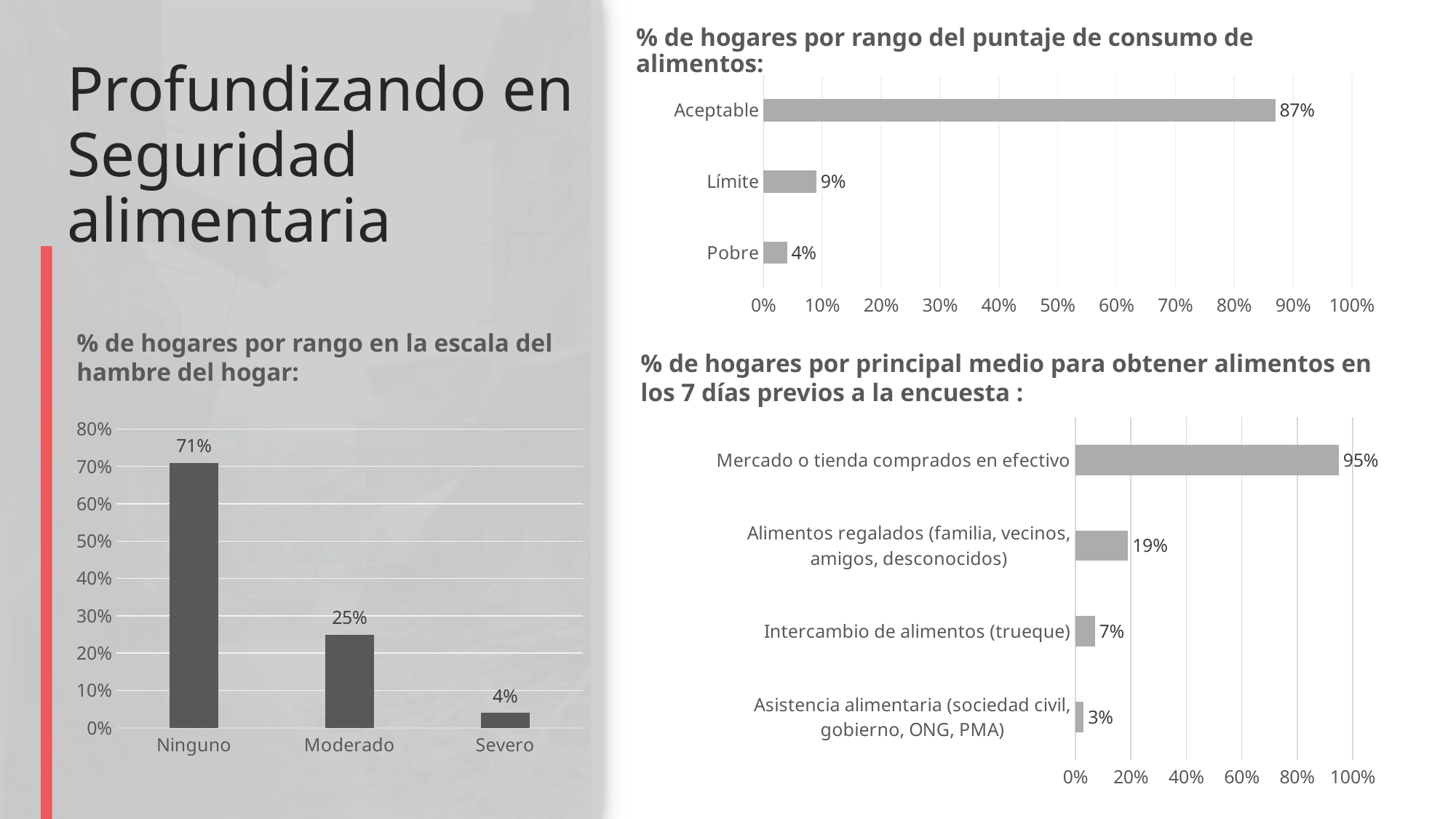
In the chart '% de hogares por rango del puntaje de consumo de alimentos', what kind of chart is it? Bar chart In the chart '% de hogares por rango en la escala del hambre del hogar', what is the value for Ninguno? 71% In the chart '% de hogares por rango en la escala del hambre del hogar', which category has the lowest value? Severo In the chart '% de hogares por principal medio para obtener alimentos en los 7 días previos a la encuesta', which is larger: Alimentos regalados or Asistencia alimentaria? Alimentos regalados In the chart '% de hogares por principal medio para obtener alimentos en los 7 días previos a la encuesta', how many categories are shown? 4 In the chart '% de hogares por rango en la escala del hambre del hogar', what is the difference between Ninguno and Moderado? 46% In the chart '% de hogares por principal medio para obtener alimentos en los 7 días previos a la encuesta', what is the value for Intercambio de alimentos (trueque)? 7% In the chart '% de hogares por rango del puntaje de consumo de alimentos', what is the value for Límite? 9% In the chart '% de hogares por rango del puntaje de consumo de alimentos', which category has the highest value? Aceptable In the chart '% de hogares por principal medio para obtener alimentos en los 7 días previos a la encuesta', what is the value for Mercado o tienda comprados en efectivo? 95% In the chart '% de hogares por rango del puntaje de consumo de alimentos', what is the difference between Aceptable and Pobre? 83% In the chart '% de hogares por rango en la escala del hambre del hogar', how many categories are shown? 3